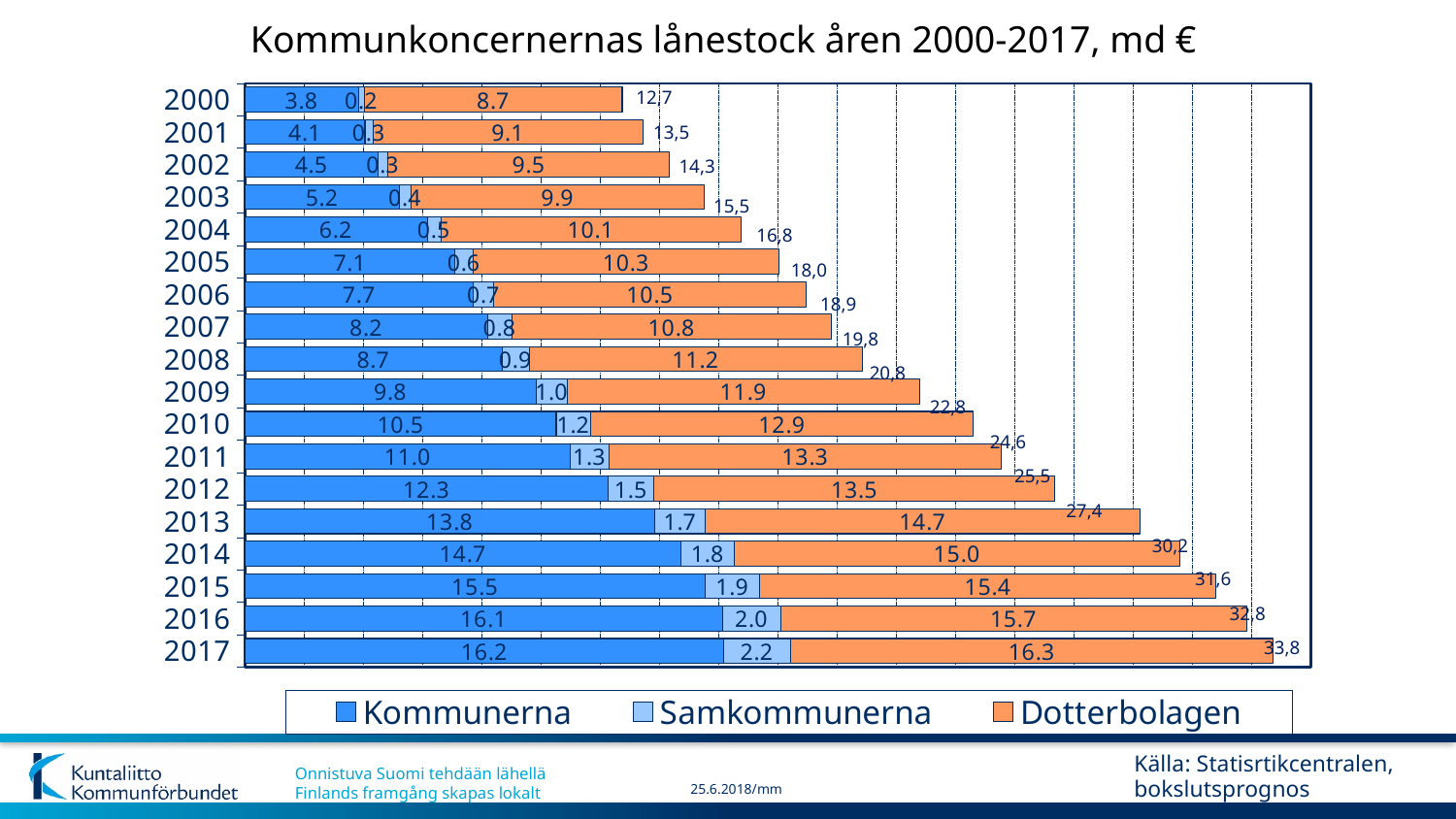
Which year has the highest total loan stock? 2017 What is the value for Samkommunerna in 2005? 0.6 How many series does the legend list? 3 How many years are shown on the chart? 18 Which year has the lowest total loan stock? 2000 What is the total loan stock shown for 2017? 33,8 In 2012, which is larger: Kommunerna or Dotterbolagen? Dotterbolagen What is the difference between the Kommunerna value in 2017 and in 2000? 12.4 Do the total values rise or fall from 2000 to 2017? rise What is the value for Dotterbolagen in 2010? 12.9 What is the value for Kommunerna in 2017? 16.2 What is the total loan stock shown for 2000? 12,7